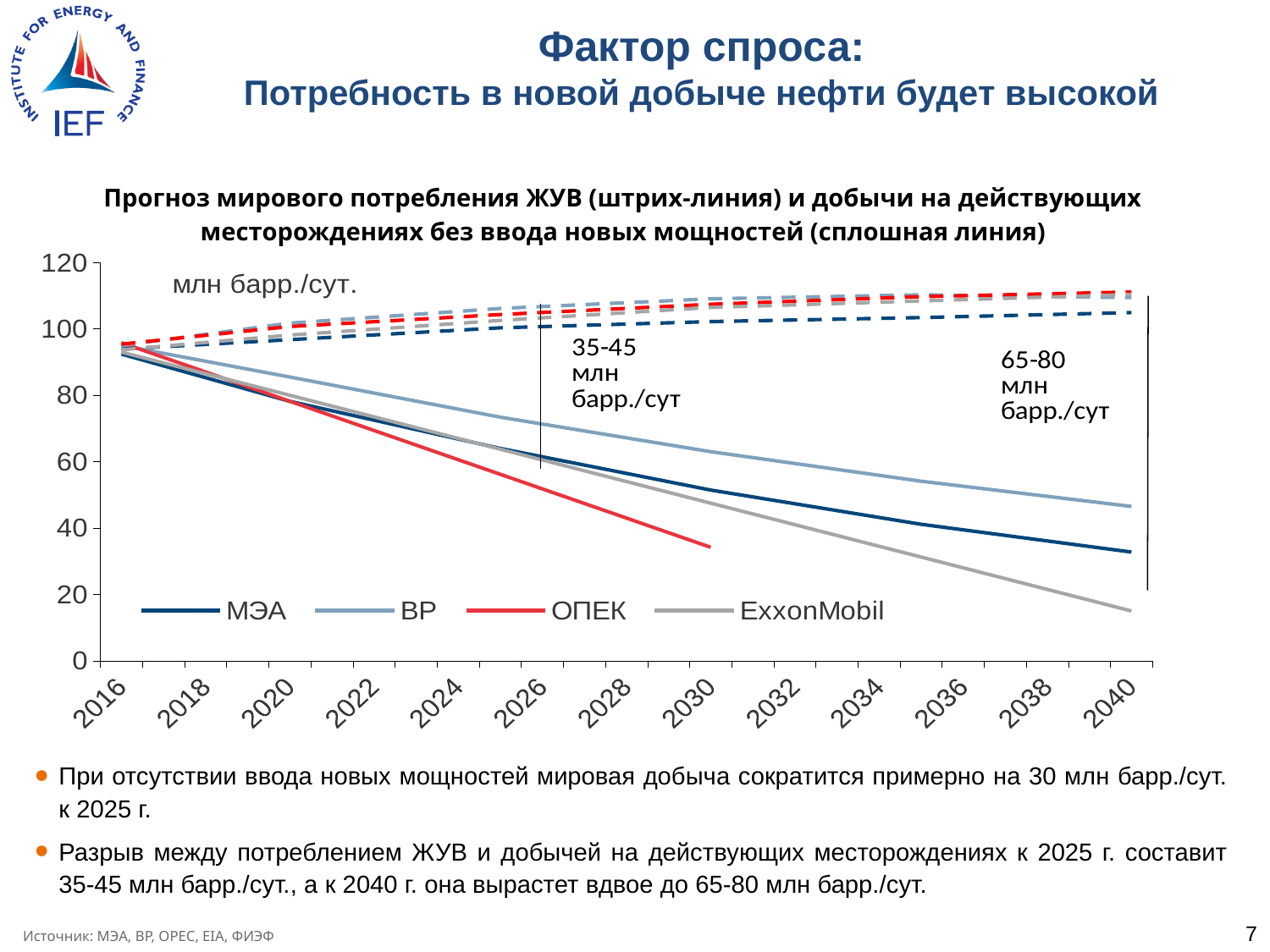
Is the solid ExxonMobil line value in 2040 greater or less than 20? less Is the solid BP line value in 2040 greater or less than 40? greater Which series has the lowest solid line value in 2040? ExxonMobil Which series has the highest solid line value in 2040? BP What gap between consumption and existing-field production is annotated on the chart for 2040? 65-80 млн барр./сут What unit is shown on the chart's y axis? млн барр./сут. Do the dashed lines (consumption forecasts) rise or fall from 2016 to 2040? rise Which organisations are listed in the chart legend? МЭА, BP, ОПЕК, ExxonMobil Do the solid lines (production on existing fields) rise or fall from 2016 to 2040? fall What kind of chart is shown on the slide? line chart In 2040, which solid line is higher: BP or МЭА? BP How many series does the chart legend list? 4